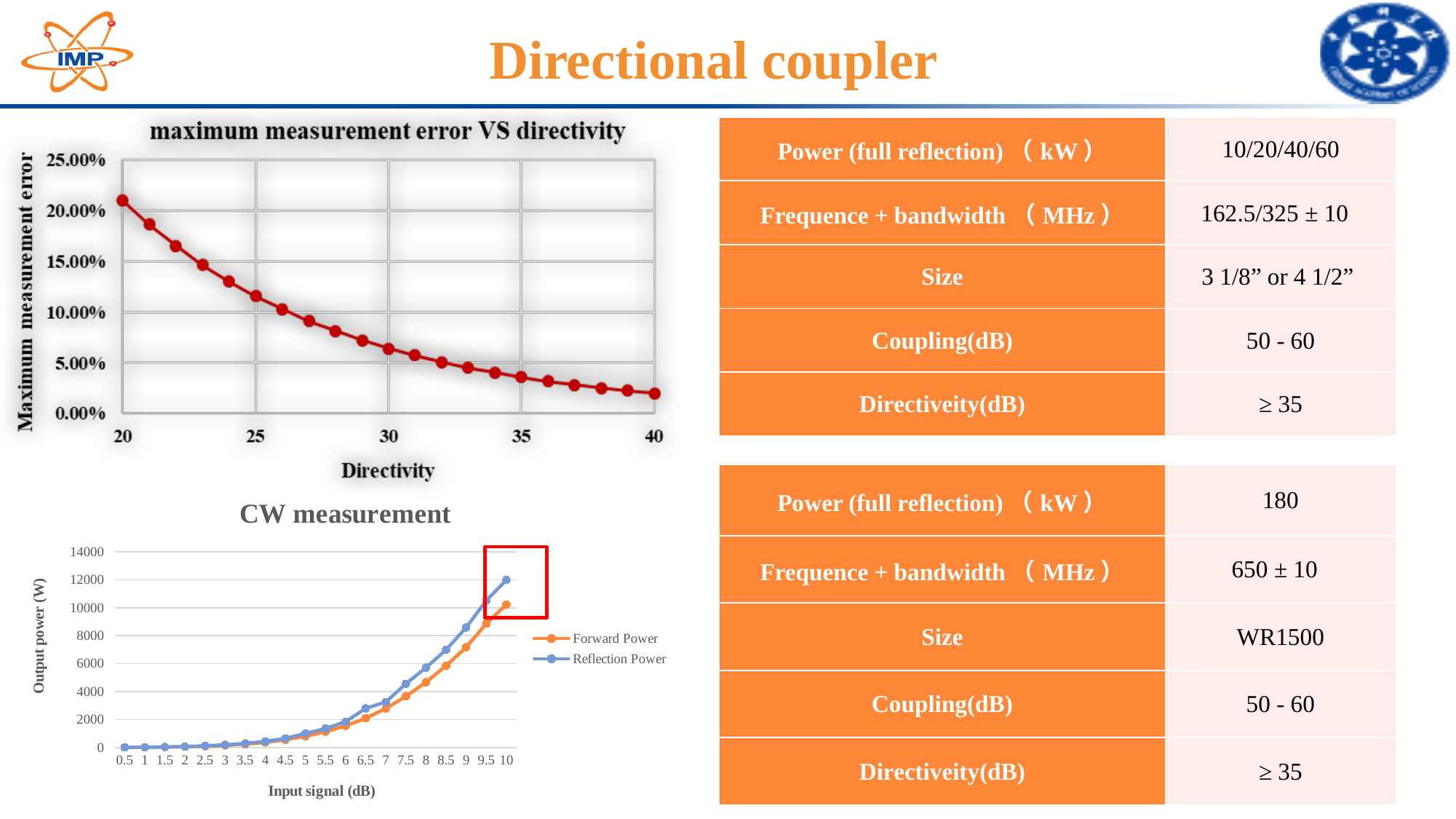
In the 'CW measurement' chart, which colour is used for the Forward Power series? orange In the 'maximum measurement error VS directivity' chart, is the value at directivity 40 greater or less than 5.00%? less What kind of chart is the 'maximum measurement error VS directivity' chart? line chart In the 'CW measurement' chart, which series is larger at an input signal of 10 dB, Forward Power or Reflection Power? Reflection Power How many series does the legend of the 'CW measurement' chart list? 2 How many input signal points are plotted along the x axis of the 'CW measurement' chart? 20 In the 'maximum measurement error VS directivity' chart, is the value at directivity 25 greater or less than 10.00%? greater In the 'CW measurement' chart, does the output power rise or fall as the input signal increases? rise In the 'maximum measurement error VS directivity' chart, what is the label of the x axis? Directivity In the 'maximum measurement error VS directivity' chart, is the value at directivity 20 greater or less than 20.00%? greater In the 'maximum measurement error VS directivity' chart, does the maximum measurement error rise or fall as directivity increases from 20 to 40? fall